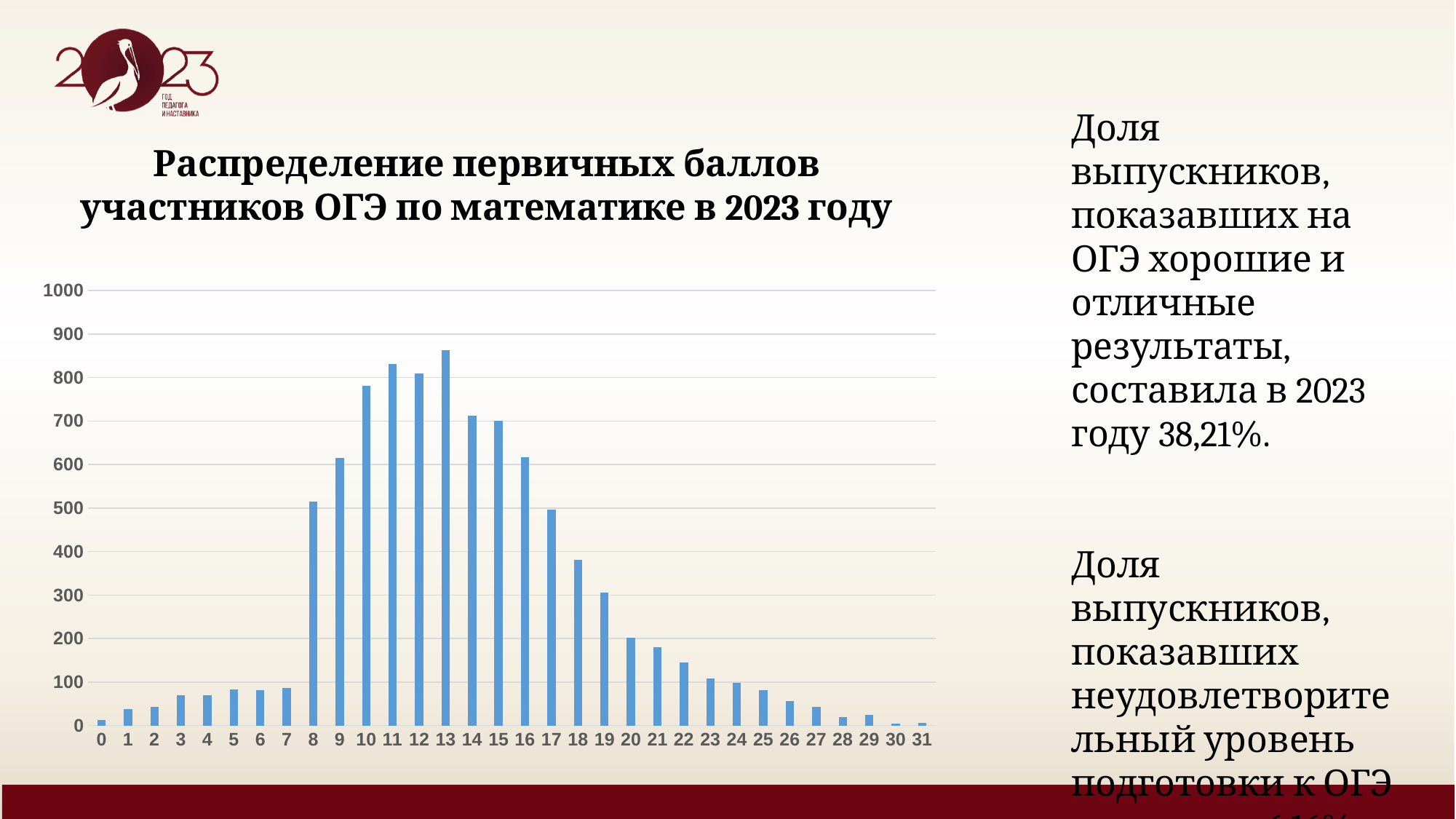
Which has the larger value, score 8 or score 18? 8 Is the value for score 22 greater or less than 200? less Is the value for score 26 greater or less than 100? less What is the title of the chart? Распределение первичных баллов участников ОГЭ по математике в 2023 году Is the value for score 18 greater or less than 400? less Which has the larger value, score 10 or score 9? 10 Do the values rise or fall along the x axis from score 13 to score 31? fall What kind of chart is shown on the slide? bar chart Which score has the highest bar? 13 How many score categories are shown along the x axis? 32